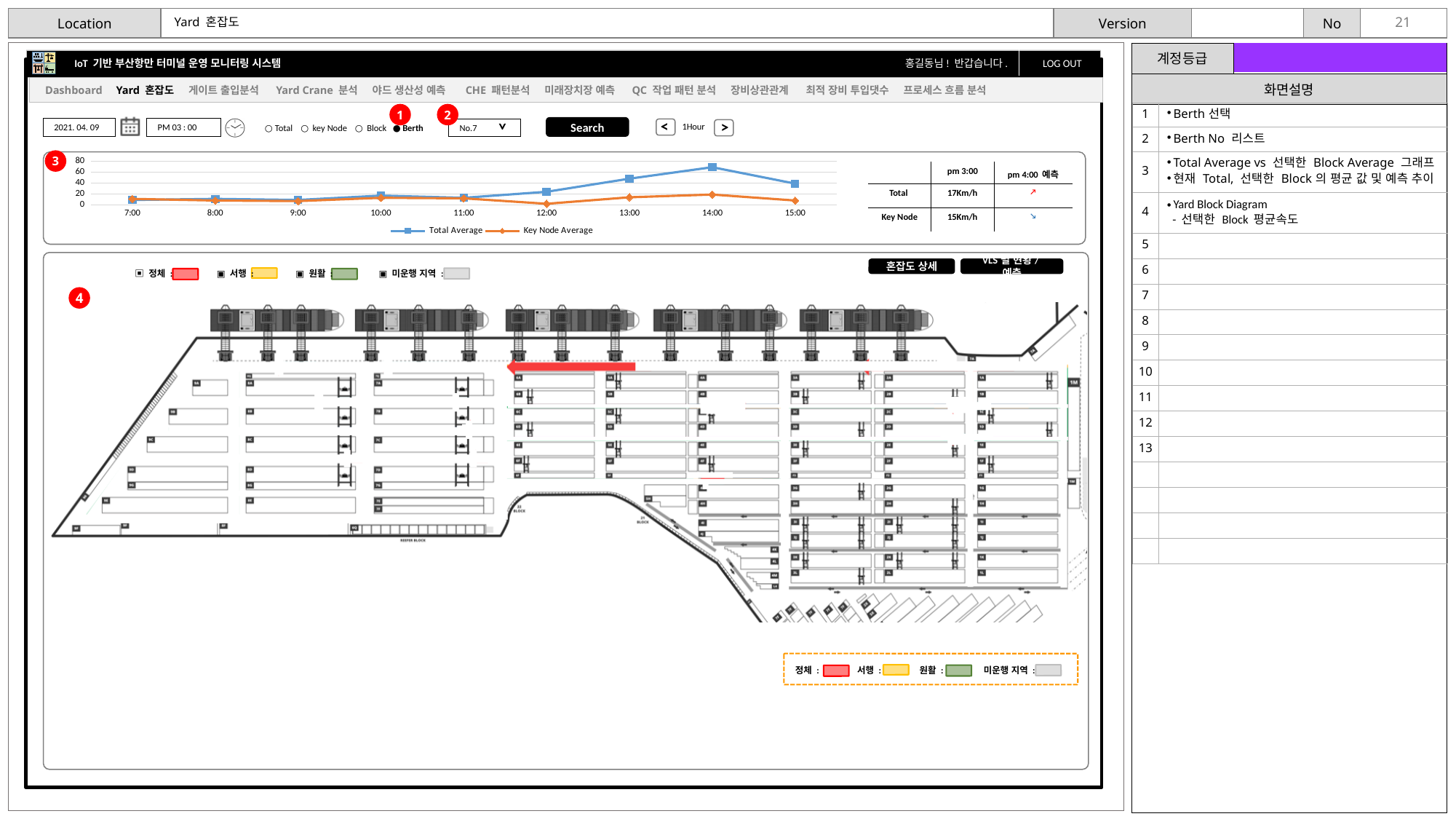
Does the Total Average series rise or fall between 14:00 and 15:00? fall Is the Total Average value at 7:00 greater or less than 20? less What kind of chart is shown at the top of the monitoring screen? line chart What are the two series names shown in the line chart's legend? Total Average, Key Node Average What colour is the Key Node Average line in the chart? orange At 14:00, which series has the larger value, Total Average or Key Node Average? Total Average At which time does the Total Average series reach its highest value? 14:00 How many time points are plotted along the x axis of the line chart? 9 Is the Total Average value at 14:00 greater or less than 60? greater Does the Total Average series rise or fall between 12:00 and 14:00? rise How many series does the legend of the line chart list? 2 Is the Key Node Average value at 14:00 greater or less than 40? less